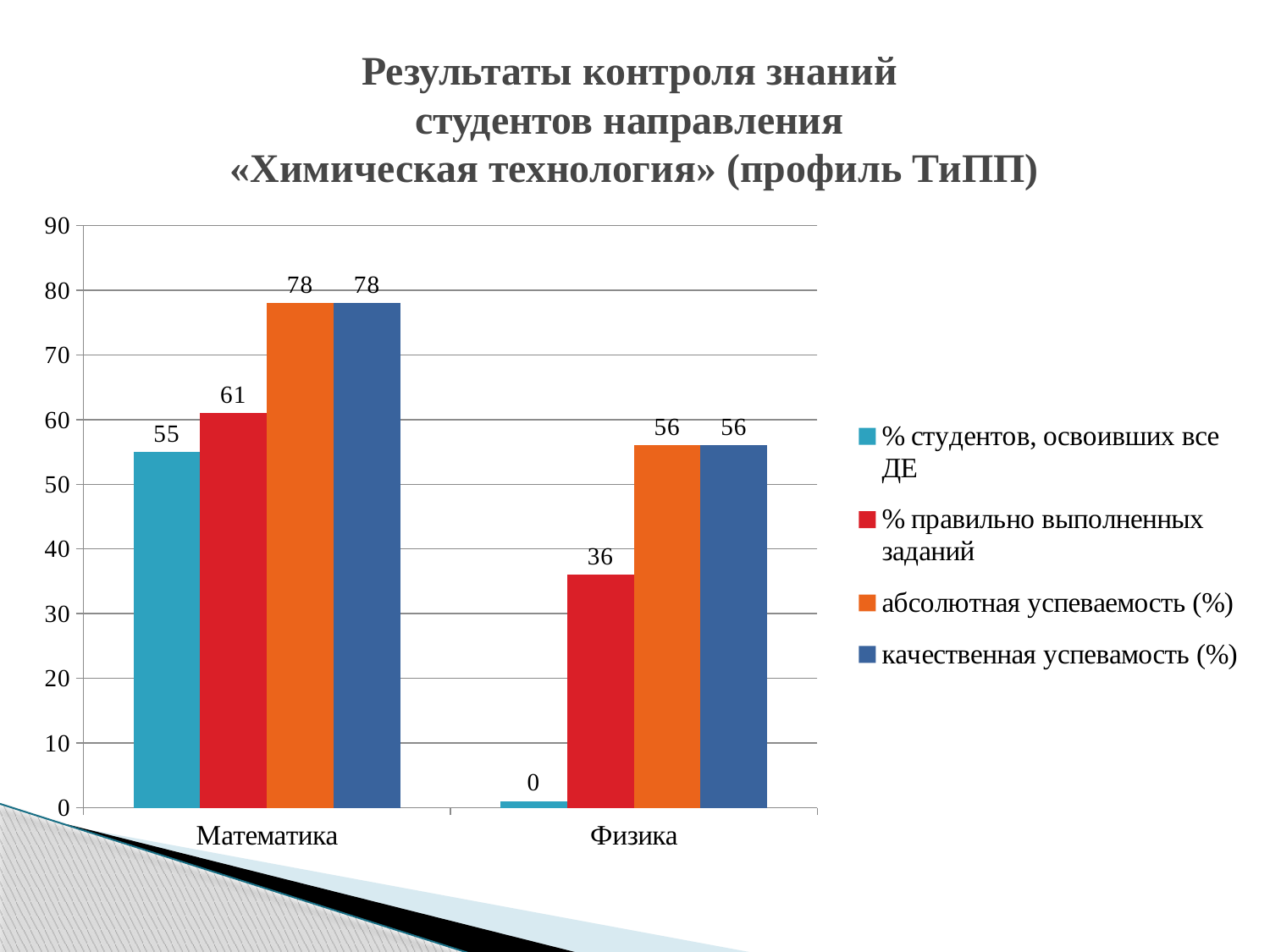
Which series has the lowest value for Физика? % студентов, освоивших все ДЕ Which is larger: «% студентов, освоивших все ДЕ» for Математика or «абсолютная успеваемость (%)» for Физика? «абсолютная успеваемость (%)» for Физика What colour are the bars for «качественная успевамость (%)»? Blue Does the value of «абсолютная успеваемость (%)» rise or fall from Математика to Физика? Fall What is the value of «% правильно выполненных заданий» for Физика? 36 What is the difference between «% правильно выполненных заданий» for Математика and for Физика? 25 How many series does the legend list? 4 How many categories are shown on the x axis? 2 What is the value of «качественная успевамость (%)» for Физика? 56 What is the value of «абсолютная успеваемость (%)» for Математика? 78 What is the value of «% студентов, освоивших все ДЕ» for Математика? 55 What kind of chart is shown on the slide? Bar chart